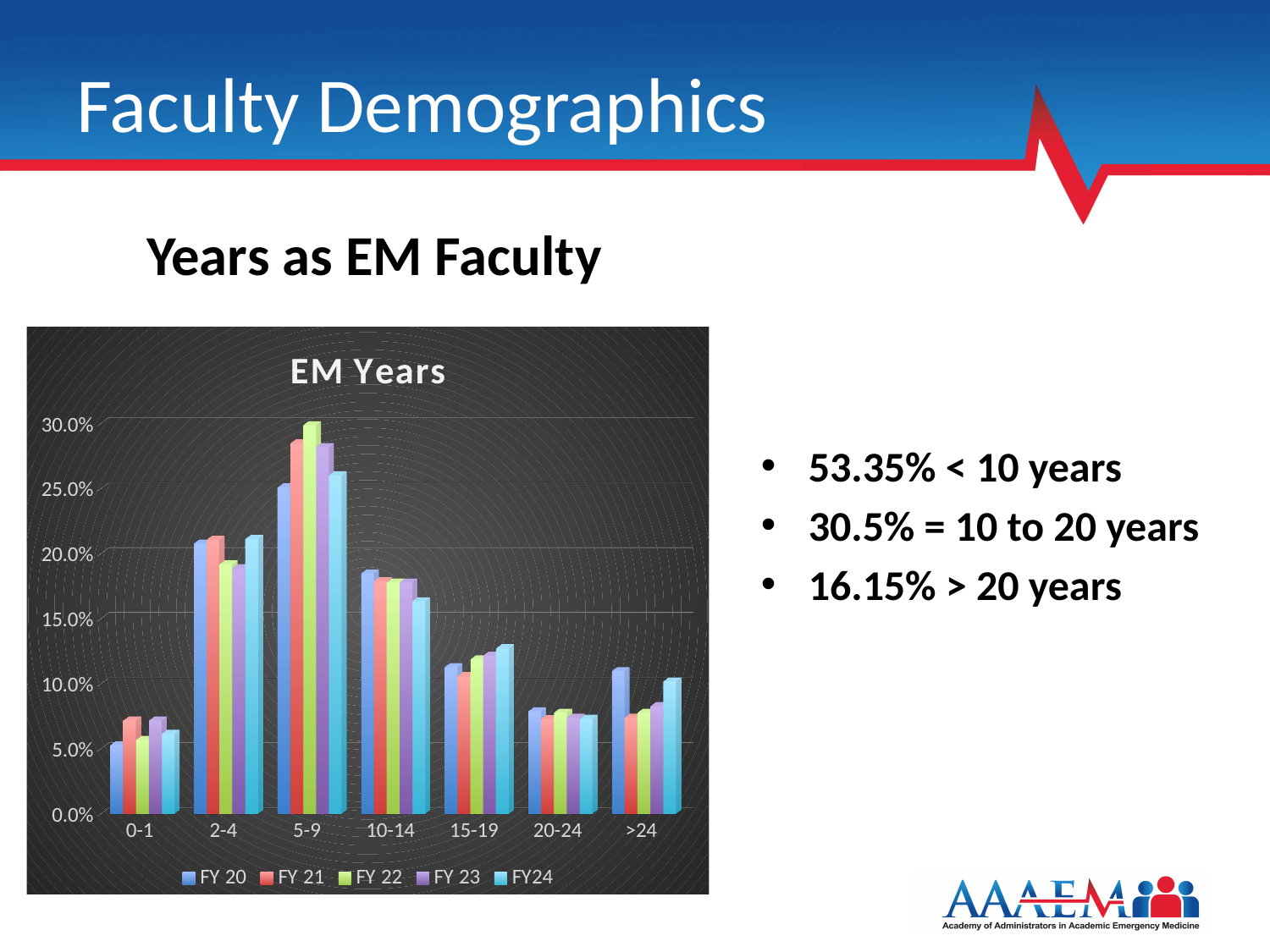
How many categories are shown on the x axis? 7 Is the value for FY 20 in the 0-1 category greater or less than 10.0%? less In the >24 category, which is larger: FY 20 or FY 21? FY 20 Which category has the lowest value for FY 20? 0-1 What kind of chart is shown on the slide? bar chart How many series does the legend list? 5 Which category has the highest value for FY 22? 5-9 For FY 21, which category has the larger value: 2-4 or 5-9? 5-9 Is the value for FY 22 in the 5-9 category greater or less than 25.0%? greater Is the value for FY 21 in the 20-24 category greater or less than 10.0%? less What is the title of the chart? EM Years